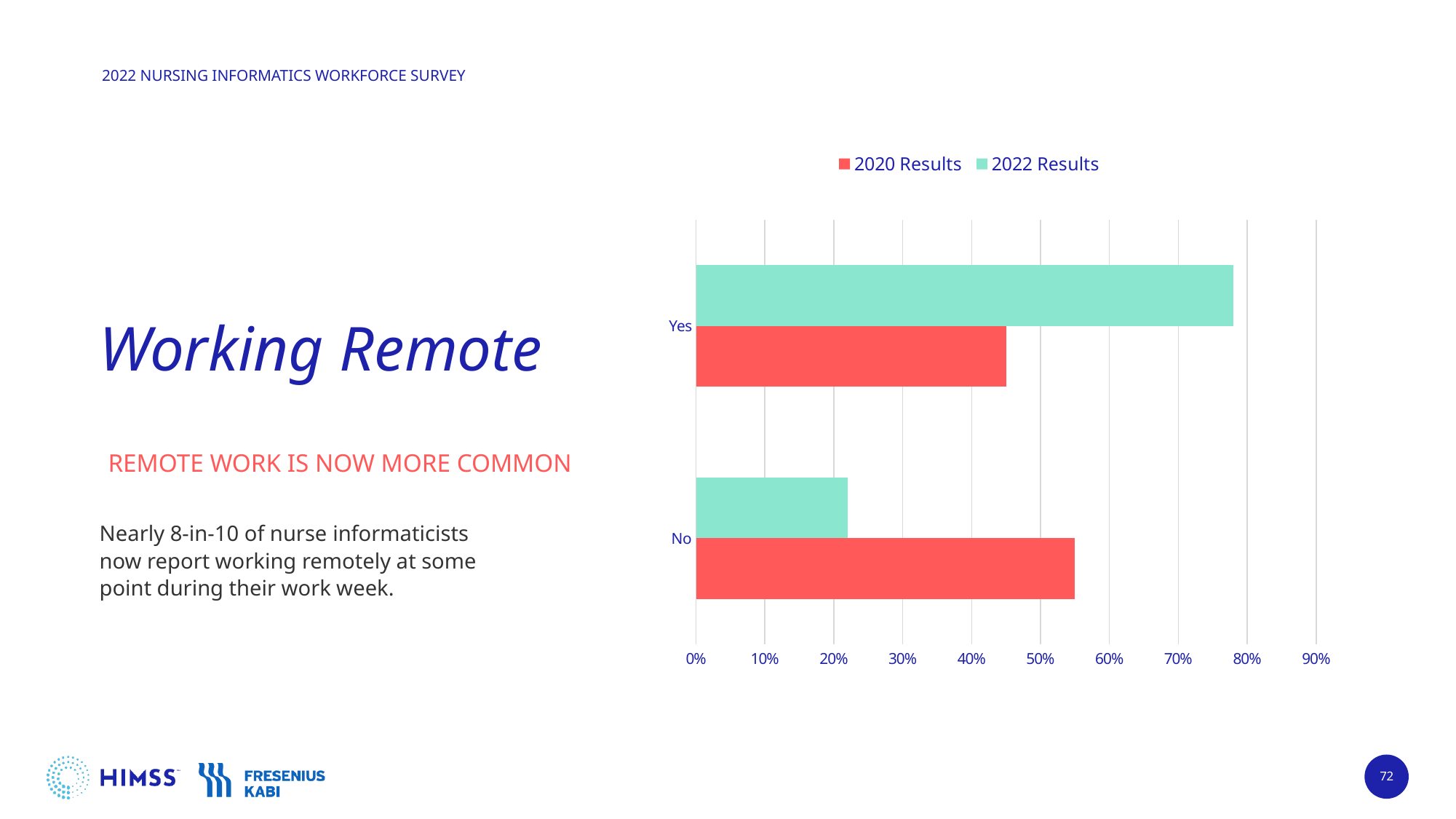
What kind of chart is shown on the slide? bar chart How many series does the legend list? 2 Which category has the lowest value for 2022 Results? No Is the 2022 Results value for No greater or less than 30%? less Which series does the legend list first? 2020 Results Is the 2020 Results value for Yes greater or less than 50%? less Which category has the highest value for 2020 Results? No How many categories are shown on the chart? 2 For the Yes category, which series has the larger value, 2020 Results or 2022 Results? 2022 Results Which category has the highest value for 2022 Results? Yes Is the 2022 Results value for Yes greater or less than 70%? greater